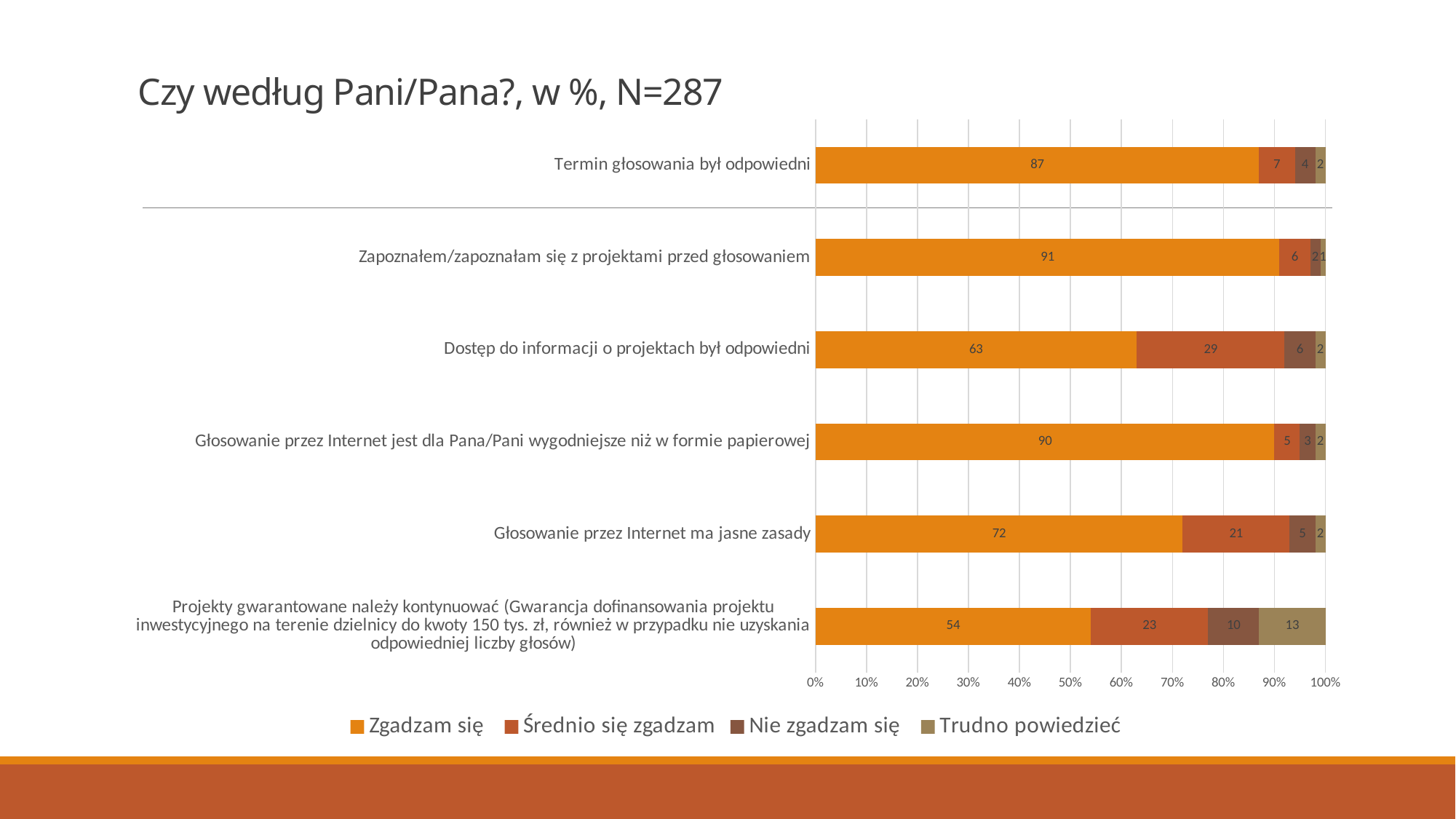
Which statement has the highest 'Zgadzam się' value? Zapoznałem/zapoznałam się z projektami przed głosowaniem Which is larger: the 'Nie zgadzam się' value for 'Projekty gwarantowane należy kontynuować' or for 'Dostęp do informacji o projektach był odpowiedni'? Projekty gwarantowane należy kontynuować What is the title of the chart? Czy według Pani/Pana?, w %, N=287 What is the 'Średnio się zgadzam' value for 'Dostęp do informacji o projektach był odpowiedni'? 29 What is the difference between the 'Zgadzam się' values for 'Głosowanie przez Internet ma jasne zasady' and 'Dostęp do informacji o projektach był odpowiedni'? 9 What is the total of the stacked bar for 'Głosowanie przez Internet jest dla Pana/Pani wygodniejsze niż w formie papierowej'? 100 What is the 'Trudno powiedzieć' value for 'Projekty gwarantowane należy kontynuować'? 13 What type of chart is shown on the slide? Stacked bar chart How many categories (statements) are shown in the chart? 6 What is the 'Zgadzam się' value for 'Termin głosowania był odpowiedni'? 87 Which statement has the lowest 'Zgadzam się' value? Projekty gwarantowane należy kontynuować How many series does the legend list? 4